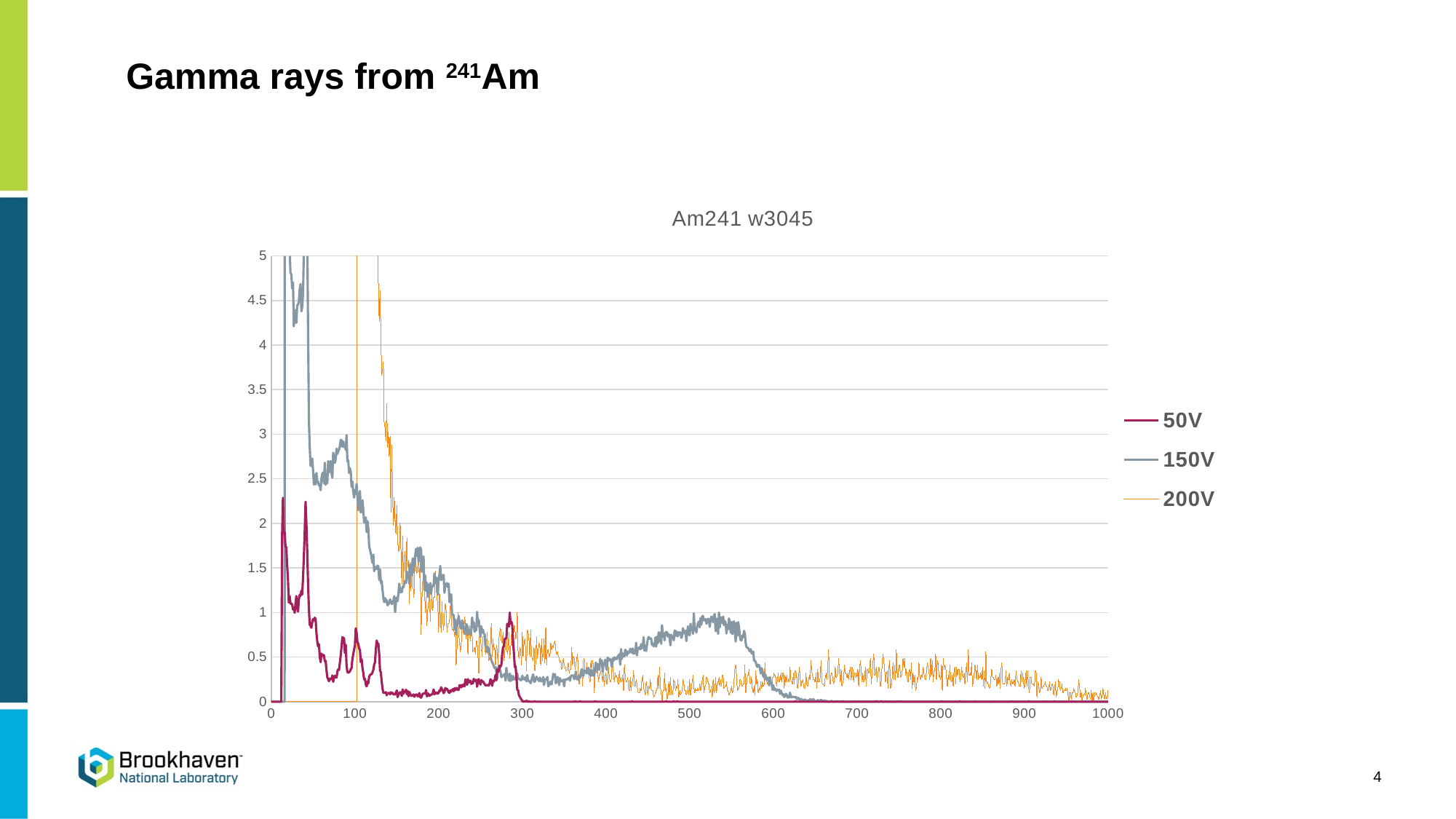
At x = 900, which series has the larger value, 50V or 200V? 200V Which series are listed in the legend? 50V, 150V, 200V Does the 150V series rise or fall between x = 550 and x = 650? fall Is the value of the 150V series at x = 100 greater or less than 2? greater Is the value of the 150V series at x = 500 greater or less than 0.5? greater What is the title of the chart? Am241 w3045 Which series has the highest value at x = 500? 150V At x = 500, which series has the larger value, 50V or 150V? 150V Is the value of the 50V series at x = 500 greater or less than 0.5? less How many series does the legend list? 3 What kind of chart is shown on the slide? line chart